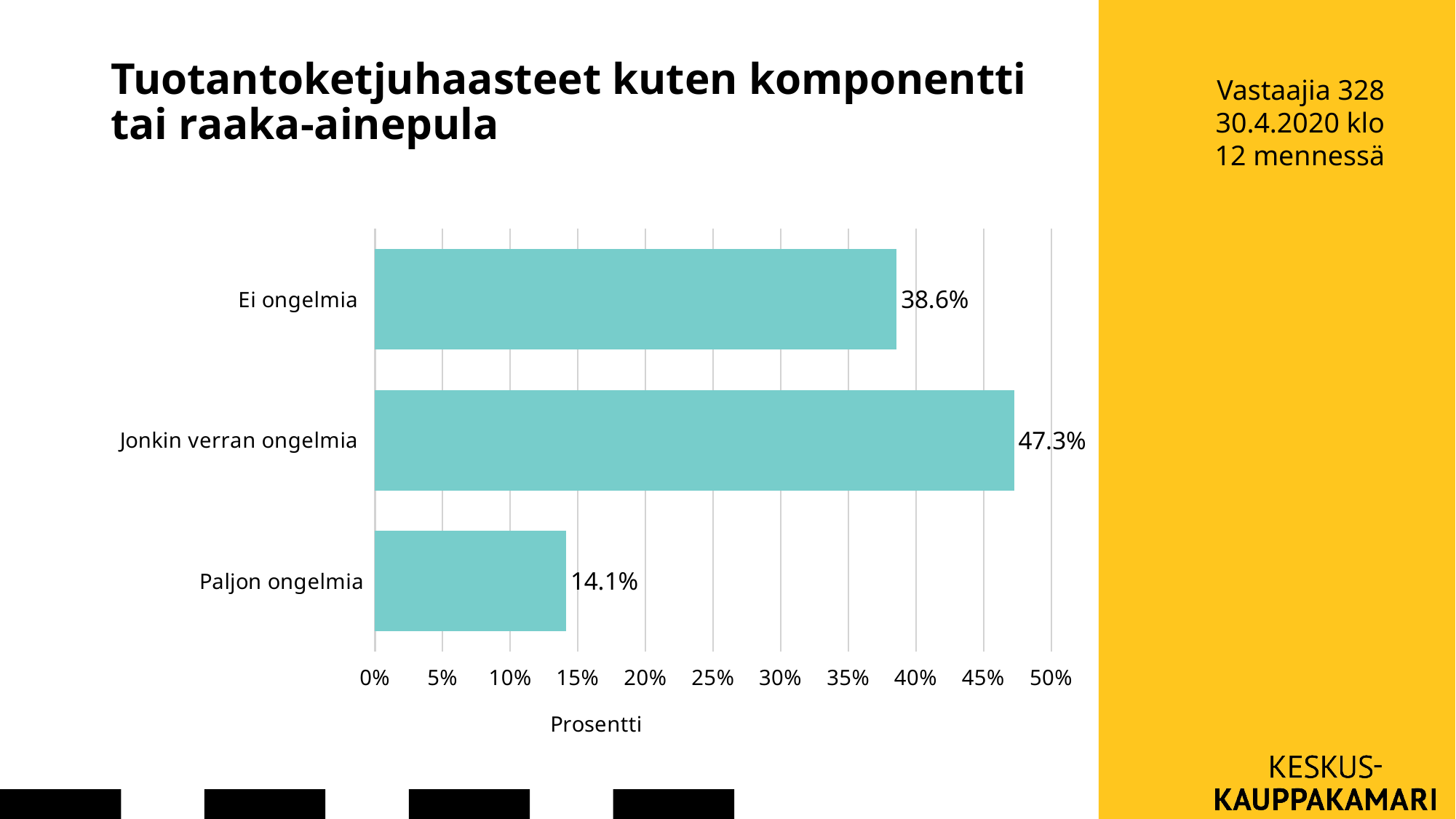
What is the difference between the values for "Jonkin verran ongelmia" and "Ei ongelmia"? 8.7% What is the label of the horizontal axis? Prosentti What kind of chart is shown on the slide? Bar chart How many categories are shown in the chart? 3 What is the difference between the values for "Ei ongelmia" and "Paljon ongelmia"? 24.5% What is the value for "Jonkin verran ongelmia"? 47.3% Is the value for "Jonkin verran ongelmia" greater or less than 45%? greater Which category has the highest value? Jonkin verran ongelmia What is the value for "Paljon ongelmia"? 14.1% Which is larger, the value for "Ei ongelmia" or the value for "Paljon ongelmia"? Ei ongelmia Which category has the lowest value? Paljon ongelmia What is the value for "Ei ongelmia"? 38.6%